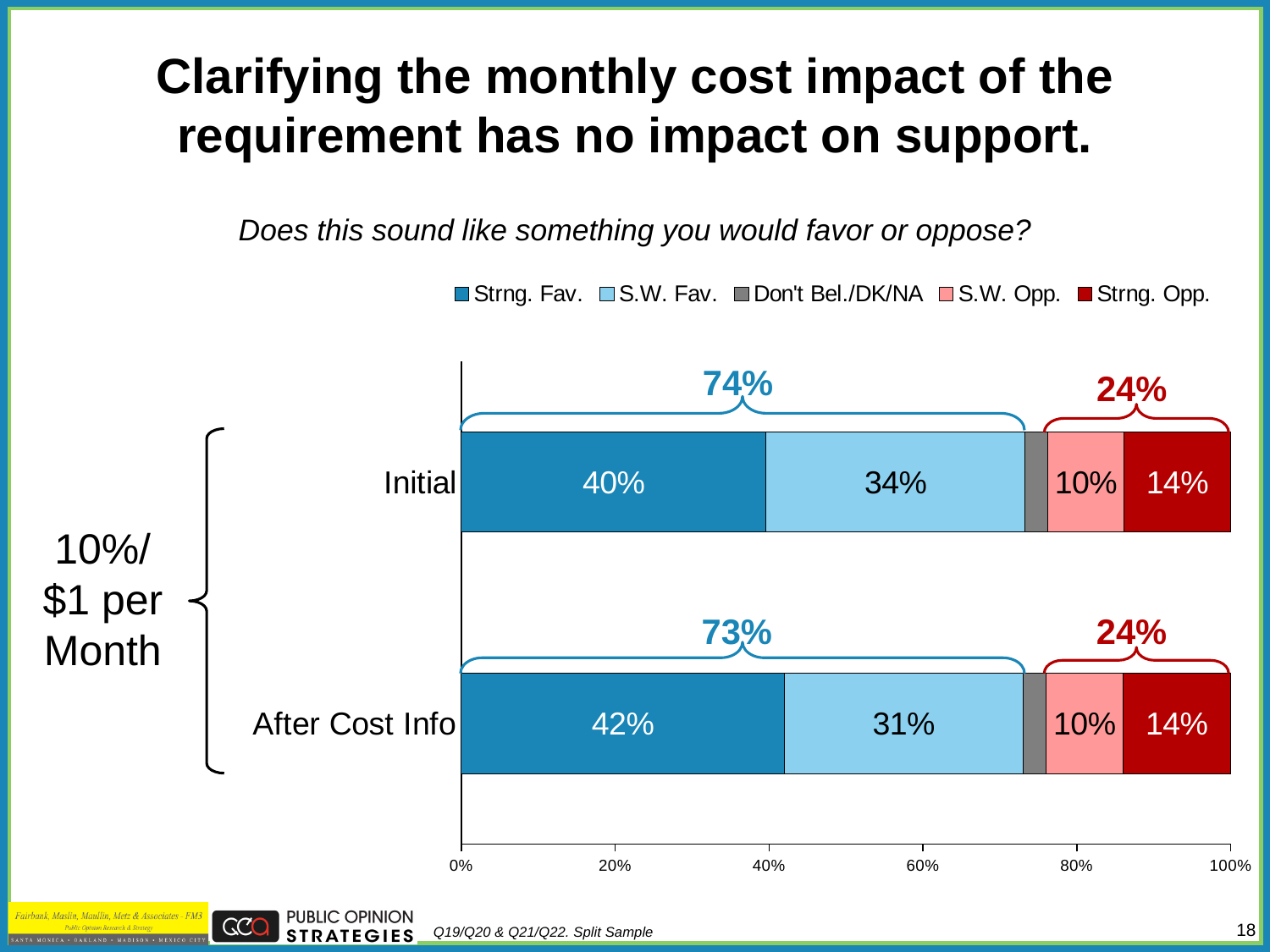
What total favorable percentage is shown by the bracket above the Initial bar? 74% How many categories (bars) are plotted in the chart? 2 What kind of chart is shown on the slide? Stacked bar chart Which bar has the larger S.W. Fav. value, Initial or After Cost Info? Initial What is the Strng. Opp. value for the After Cost Info bar? 14% Which legend entry is shown in dark red? Strng. Opp. What is the Strng. Fav. value for the Initial bar? 40% What is the S.W. Fav. value for the After Cost Info bar? 31% What is the difference between the Strng. Fav. values for After Cost Info and Initial? 2% What total opposed percentage is shown by the bracket above the After Cost Info bar? 24% What is the S.W. Opp. value for the Initial bar? 10% How many series does the legend list? 5